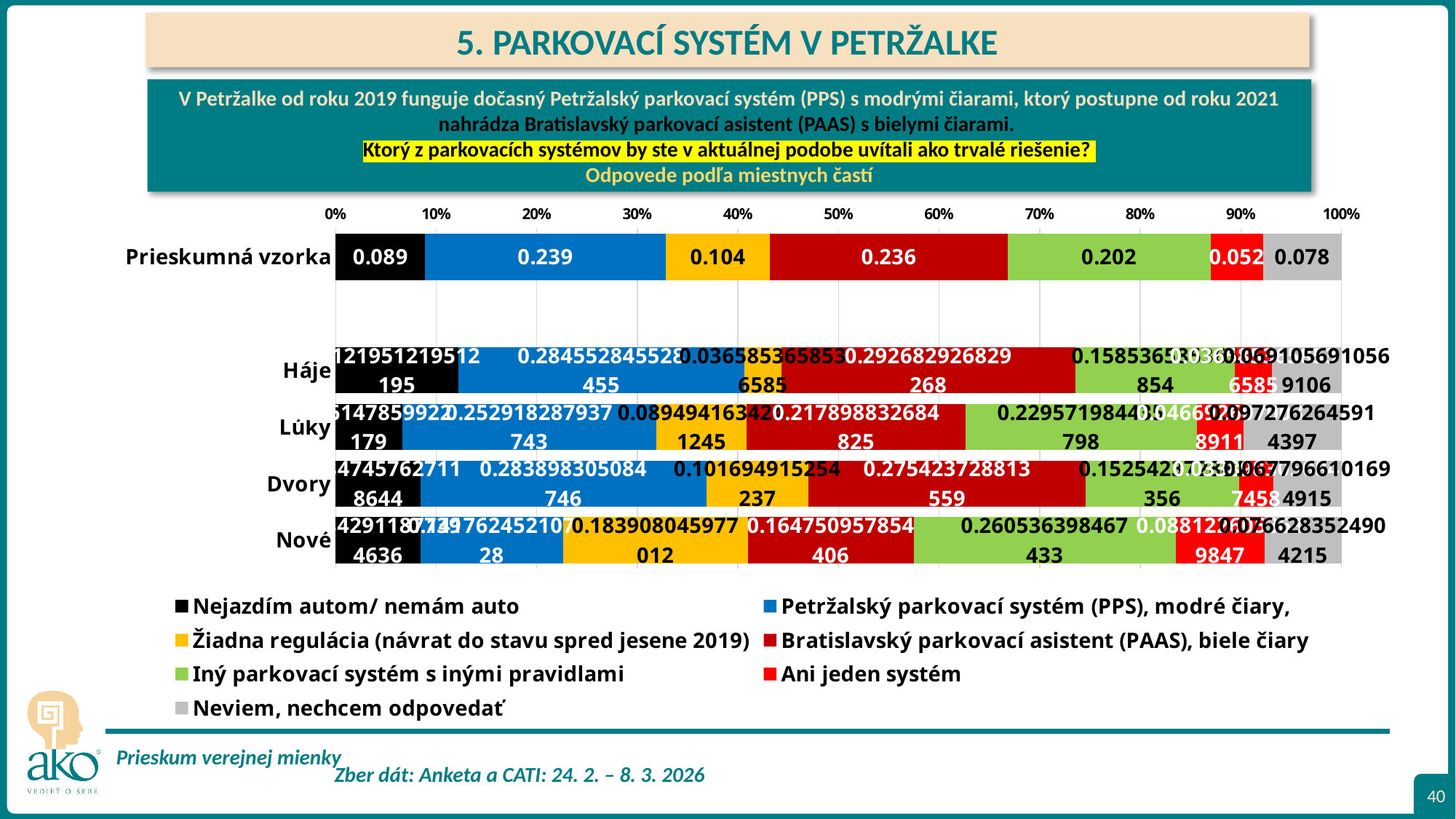
Which colour represents 'Ani jeden systém' in the chart? red In the 'Prieskumná vzorka' bar, which is larger: the value for 'Nejazdím autom/ nemám auto' or the value for 'Žiadna regulácia (návrat do stavu spred jesene 2019)'? Žiadna regulácia (návrat do stavu spred jesene 2019) What is the value for 'Petržalský parkovací systém (PPS), modré čiary' in the 'Prieskumná vzorka' bar? 0.239 What is the value for 'Ani jeden systém' in the 'Prieskumná vzorka' bar? 0.052 What is the value for 'Nejazdím autom/ nemám auto' in the 'Prieskumná vzorka' bar? 0.089 What is the value for 'Neviem, nechcem odpovedať' in the 'Prieskumná vzorka' bar? 0.078 How many series does the legend list? 7 In the 'Prieskumná vzorka' bar, which series has the largest value? Petržalský parkovací systém (PPS), modré čiary In the 'Prieskumná vzorka' bar, what is the difference between the values for 'Iný parkovací systém s inými pravidlami' and 'Žiadna regulácia (návrat do stavu spred jesene 2019)'? 0.098 What is the value for 'Bratislavský parkovací asistent (PAAS), biele čiary' in the 'Prieskumná vzorka' bar? 0.236 What type of chart is shown on the slide? stacked bar chart In the 'Prieskumná vzorka' bar, which series has the smallest value? Ani jeden systém